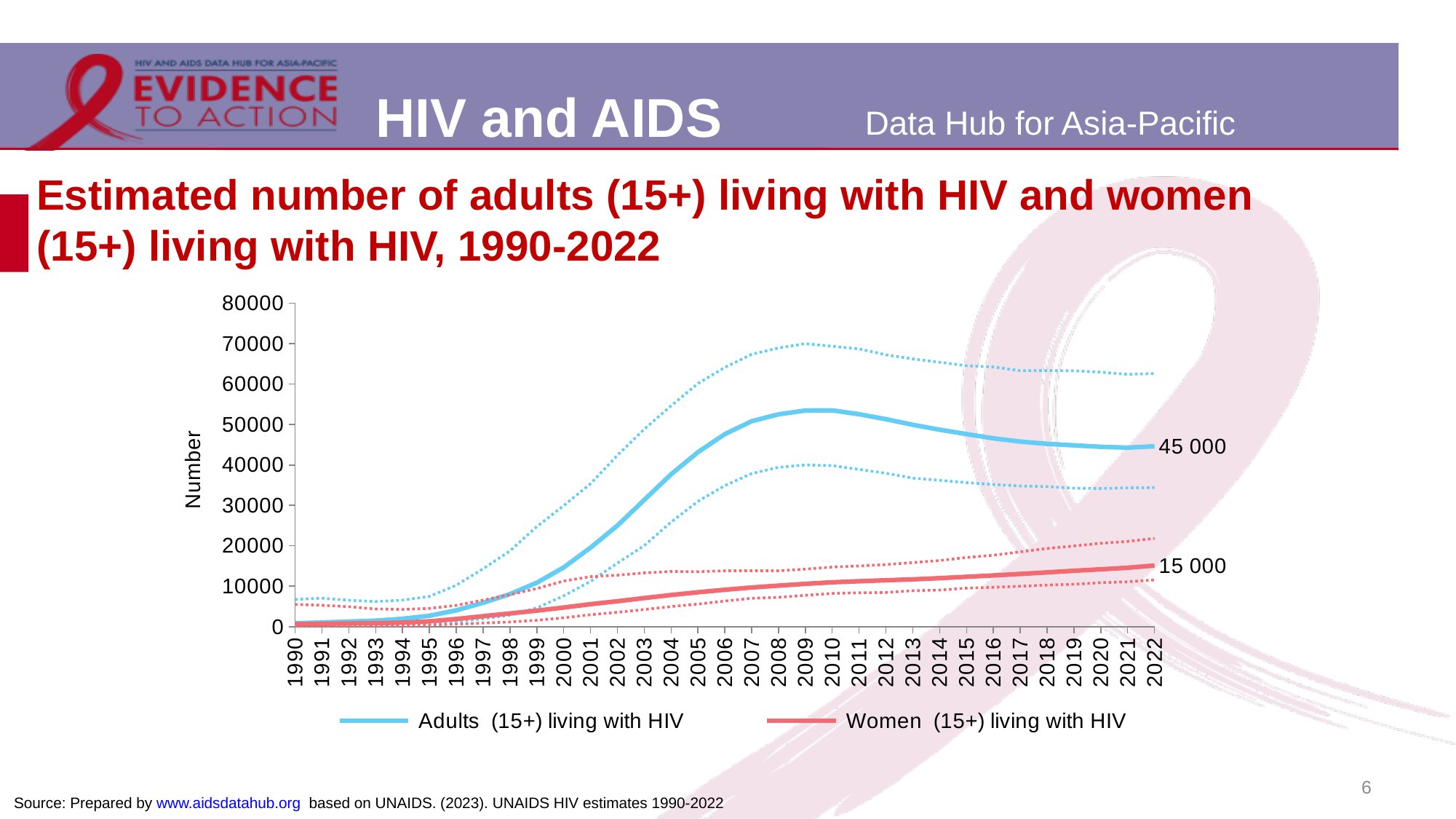
Is the value for Women (15+) living with HIV in 2010 greater or less than 20000? less Does the number of adults (15+) living with HIV rise or fall between 2010 and 2022? Fall In 2022, which series has the larger value: Adults (15+) living with HIV or Women (15+) living with HIV? Adults (15+) living with HIV What is the estimated number of adults (15+) living with HIV in 2022? 45 000 What kind of chart is shown on the slide? Line chart What is the label on the y axis of the chart? Number How many series does the legend list? 2 Is the value for Adults (15+) living with HIV in 2009 greater or less than 50000? greater What is the difference between the number of adults (15+) living with HIV and women (15+) living with HIV in 2022? 30 000 What is the estimated number of women (15+) living with HIV in 2022? 15 000 Does the number of women (15+) living with HIV rise or fall between 1990 and 2022? Rise How many years are shown on the x axis? 33